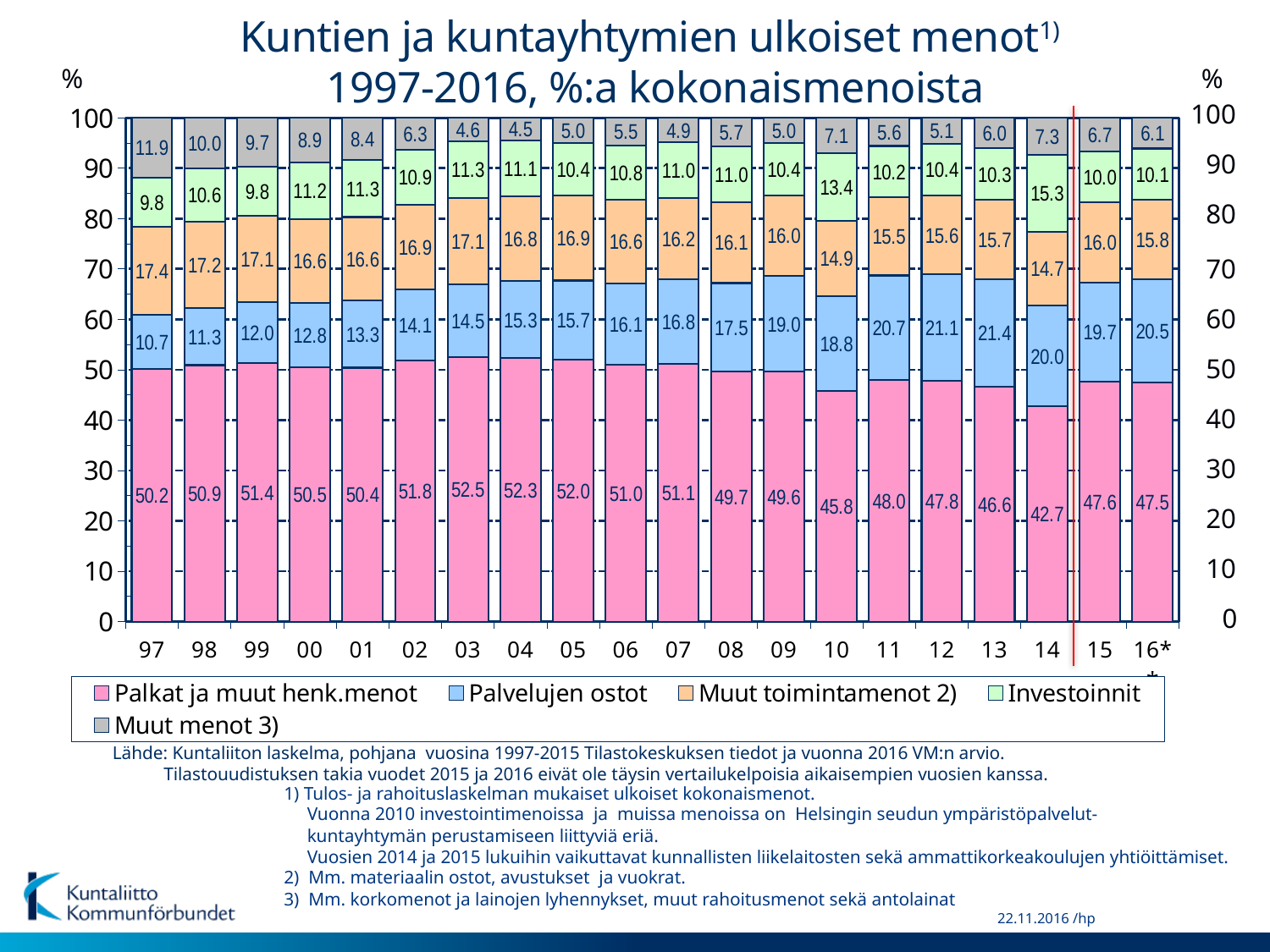
What is the value for Investoinnit in 2010? 13.4 What is the value for Palkat ja muut henk.menot in 2003? 52.5 What is the value for Muut menot 3) in 1997? 11.9 In which year is the Investoinnit share the highest? 14 What kind of chart is shown on the slide? Stacked bar chart How many years are shown on the x axis? 20 In which year is the Palkat ja muut henk.menot share the lowest? 14 Does the Palvelujen ostot share generally rise or fall from 1997 to 2013? Rise Which is larger, Muut toimintamenot 2) in 1997 or in 2014? 1997 What is the value for Palvelujen ostot in 2016*? 20.5 How many series does the legend list? 5 What is the difference between the Palvelujen ostot values in 2013 and 1997? 10.7